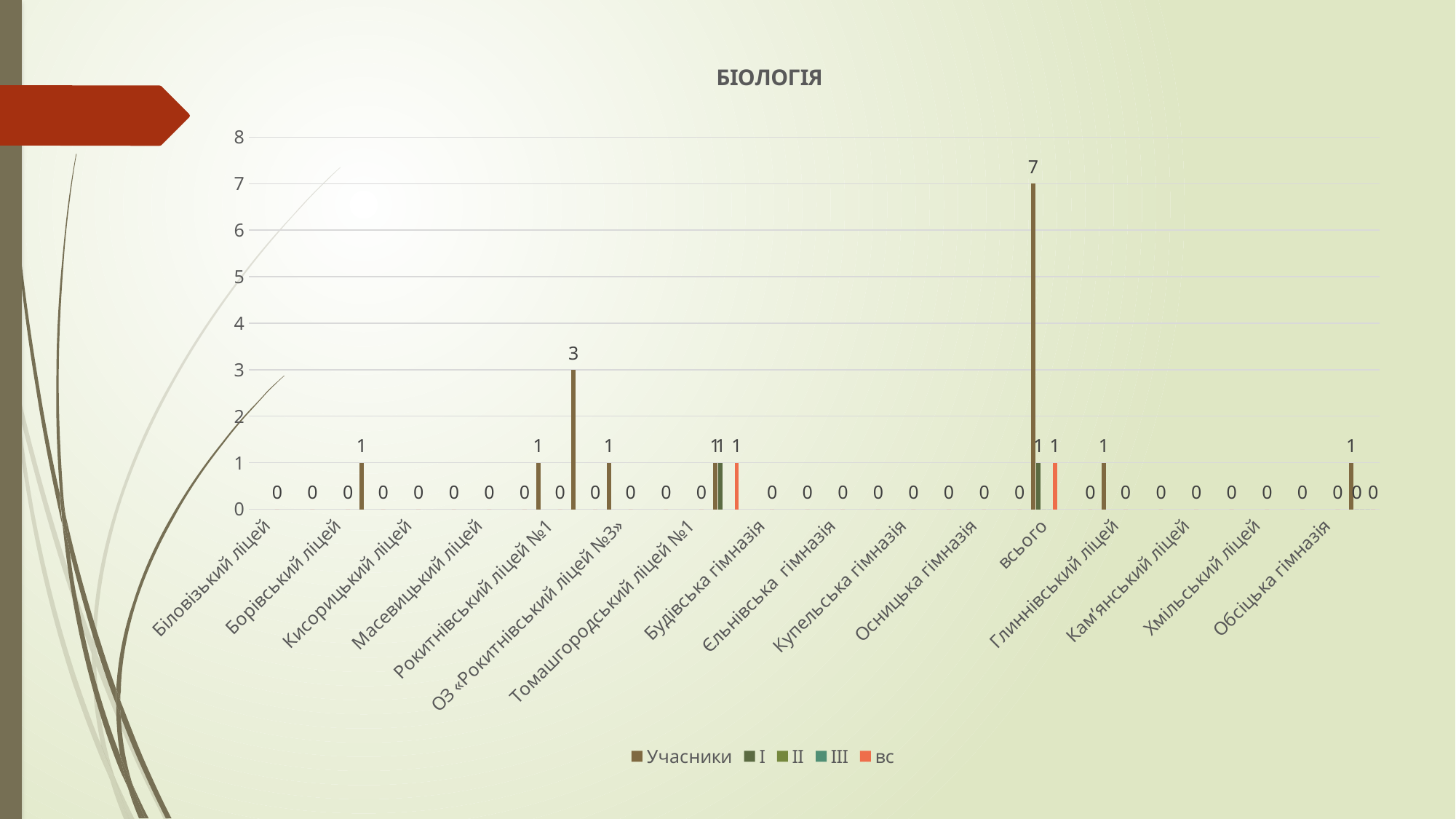
What is the title of the chart? БІОЛОГІЯ How many series does the legend list? 5 What is the Учасники value for Глиннівський ліцей? 1 What type of chart is shown on the slide? bar chart What is the Учасники value for ОЗ «Рокитнівський ліцей №3»? 1 Which is larger, the Учасники value for ОЗ «Рокитнівський ліцей №3» or for Борівський ліцей? ОЗ «Рокитнівський ліцей №3» Which category has the highest Учасники value? всього What is the Учасники value for всього? 7 What is the difference between the Учасники values for всього and ОЗ «Рокитнівський ліцей №3»? 6